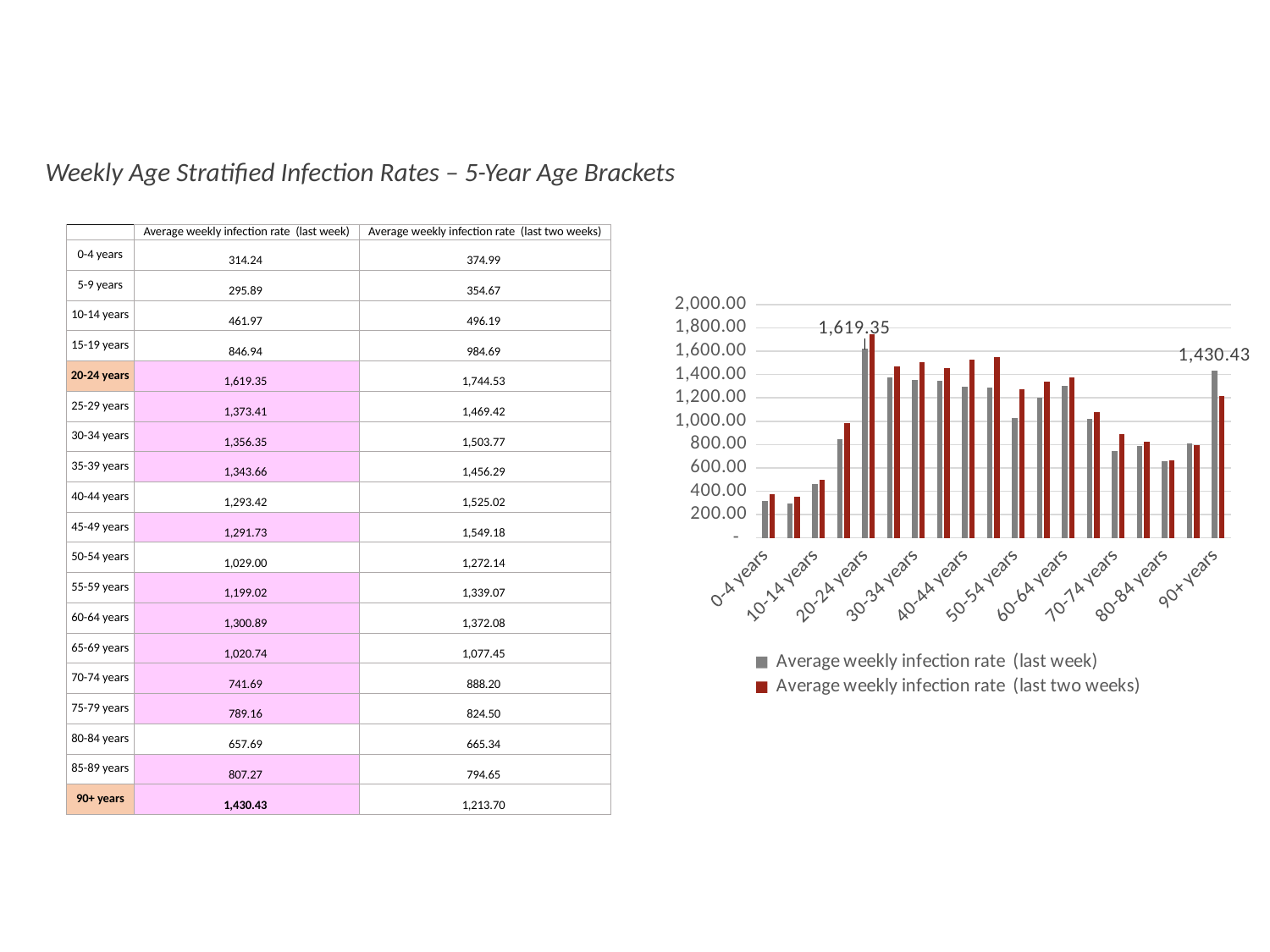
What kind of chart is shown on the slide? Bar chart Is the 'Average weekly infection rate (last week)' value for 0-4 years greater or less than 400.00? less What is the data label shown on the chart for the 90+ years bar in the 'Average weekly infection rate (last week)' series? 1,430.43 Is the 'Average weekly infection rate (last two weeks)' value for 90+ years greater or less than 1,000.00? greater How many series does the chart legend list? 2 Do the 'Average weekly infection rate (last week)' values rise or fall from 0-4 years to 20-24 years along the x axis? Rise Which age bracket has the highest 'Average weekly infection rate (last week)' in the chart? 20-24 years What is the difference between the two labelled values on the chart, 1,619.35 for 20-24 years and 1,430.43 for 90+ years? 188.92 What is the data label shown on the chart for the 20-24 years bar in the 'Average weekly infection rate (last week)' series? 1,619.35 For 20-24 years, which is larger in the chart: the last week rate or the last two weeks rate? Last two weeks For 90+ years, which is larger in the chart: the last week rate or the last two weeks rate? Last week Which colour represents the 'Average weekly infection rate (last two weeks)' series in the chart? Red